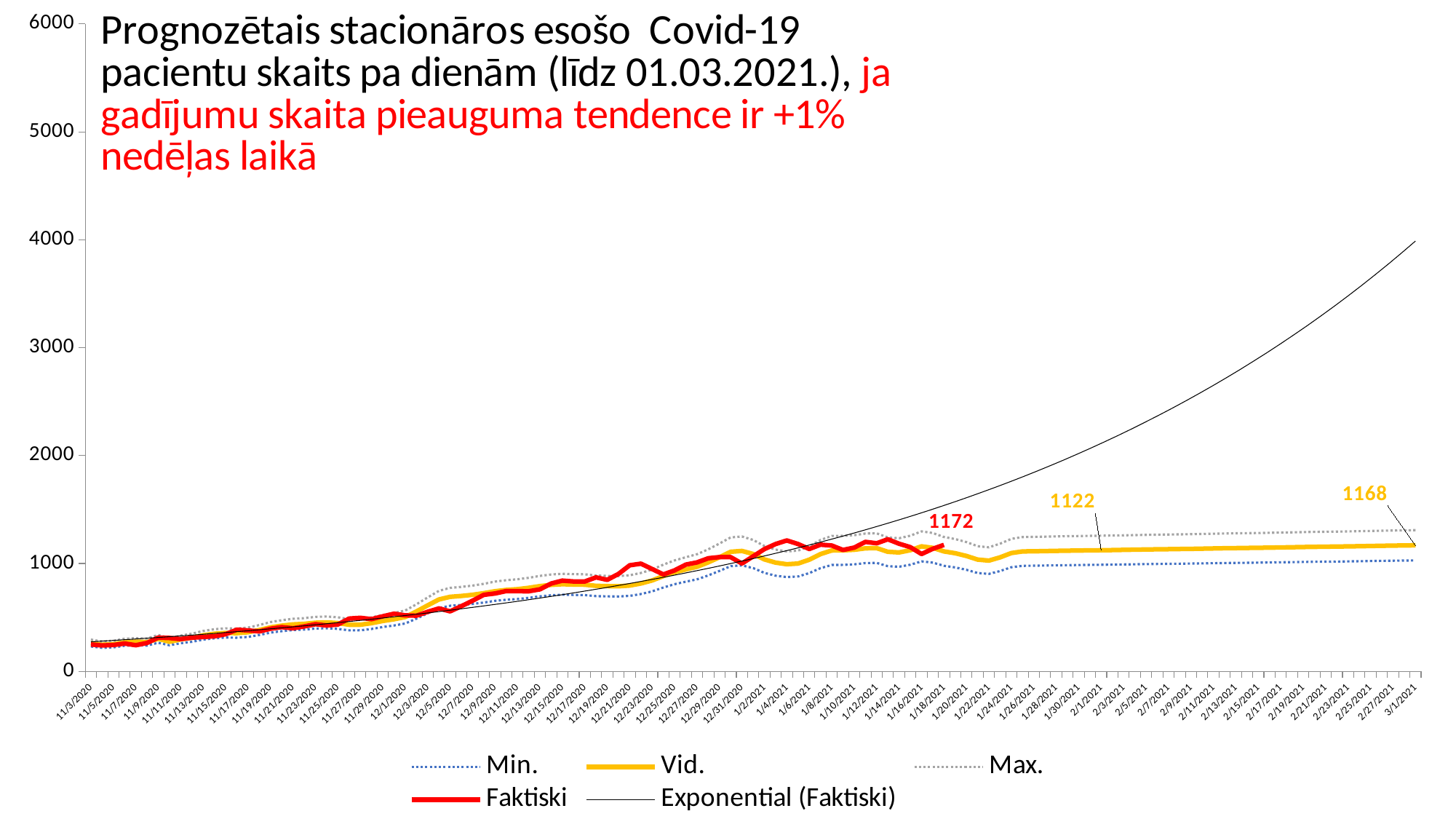
What is the labelled value of the Vid. series at 2/1/2021? 1122 What is the labelled value of the Faktiski series at its last point? 1172 How many series does the legend list? 5 What kind of chart is shown on the slide? line chart Which is larger: the labelled Faktiski value (1172) or the labelled Vid. value at 3/1/2021 (1168)? Faktiski (1172) What is the labelled value of the Vid. series at 3/1/2021? 1168 What is the difference between the two labelled Vid. values, 1168 and 1122? 46 Which series has the highest value at 3/1/2021? Exponential (Faktiski) Does the Exponential (Faktiski) series rise or fall along the x axis? rise Is the value of the Exponential (Faktiski) series at 3/1/2021 greater or less than 3000? greater Is the value of the Min. series at 3/1/2021 greater or less than 2000? less What colour is the Faktiski series line? red